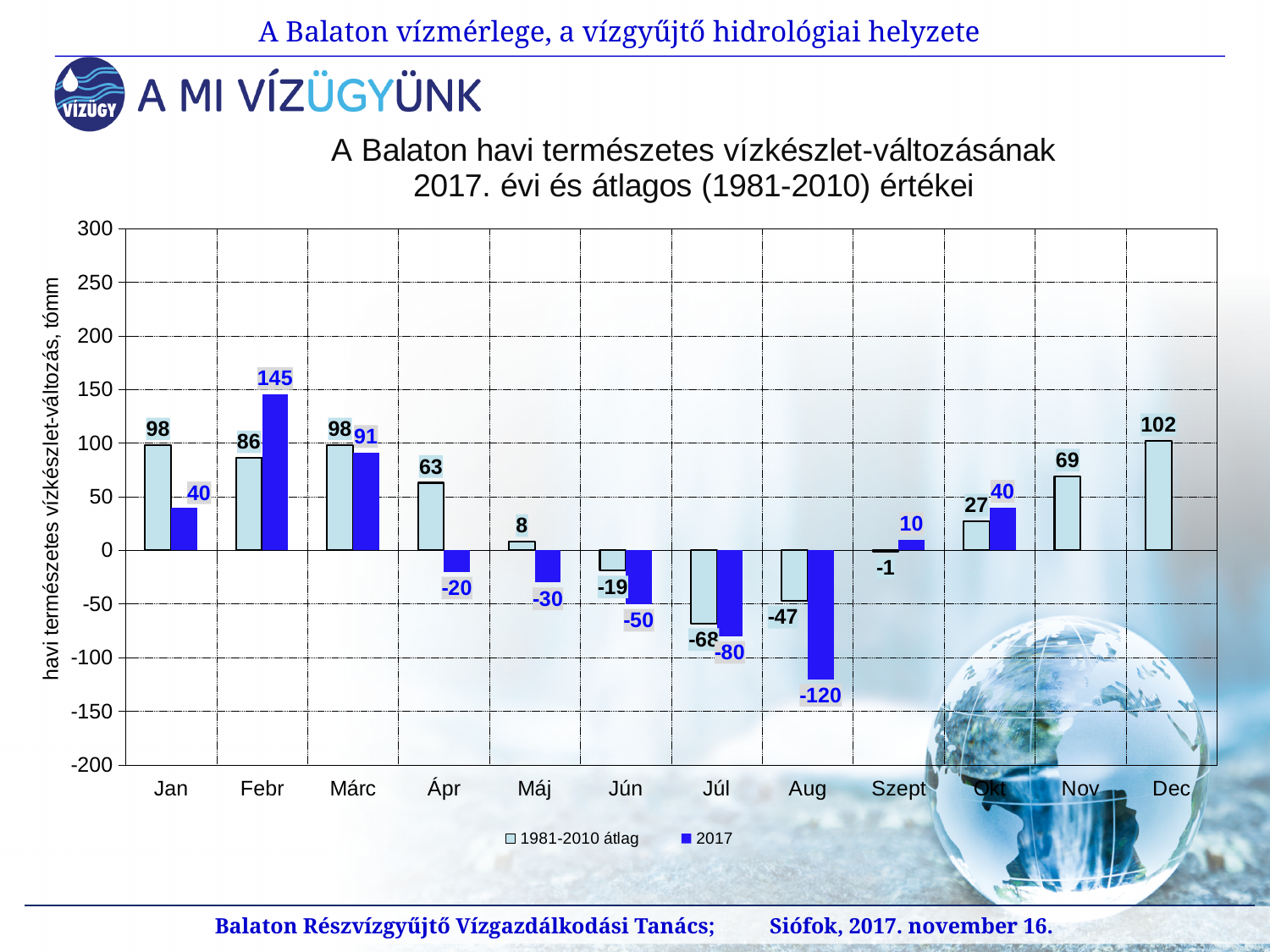
Which is larger for Márc, the 1981-2010 átlag value or the 2017 value? 1981-2010 átlag What is the label of the y axis? havi természetes vízkészlet-változás, tómm How many months are shown on the x axis? 12 What type of chart is shown on the slide? bar chart How many series does the legend list? 2 Which month has the lowest 1981-2010 átlag value? Júl What is the 1981-2010 átlag value for Dec? 102 Which month has the highest 2017 value? Febr What is the 1981-2010 átlag value for Szept? -1 What is the 2017 value for Febr? 145 What is the 2017 value for Aug? -120 What is the difference between the 2017 value and the 1981-2010 átlag value for Jan? 58